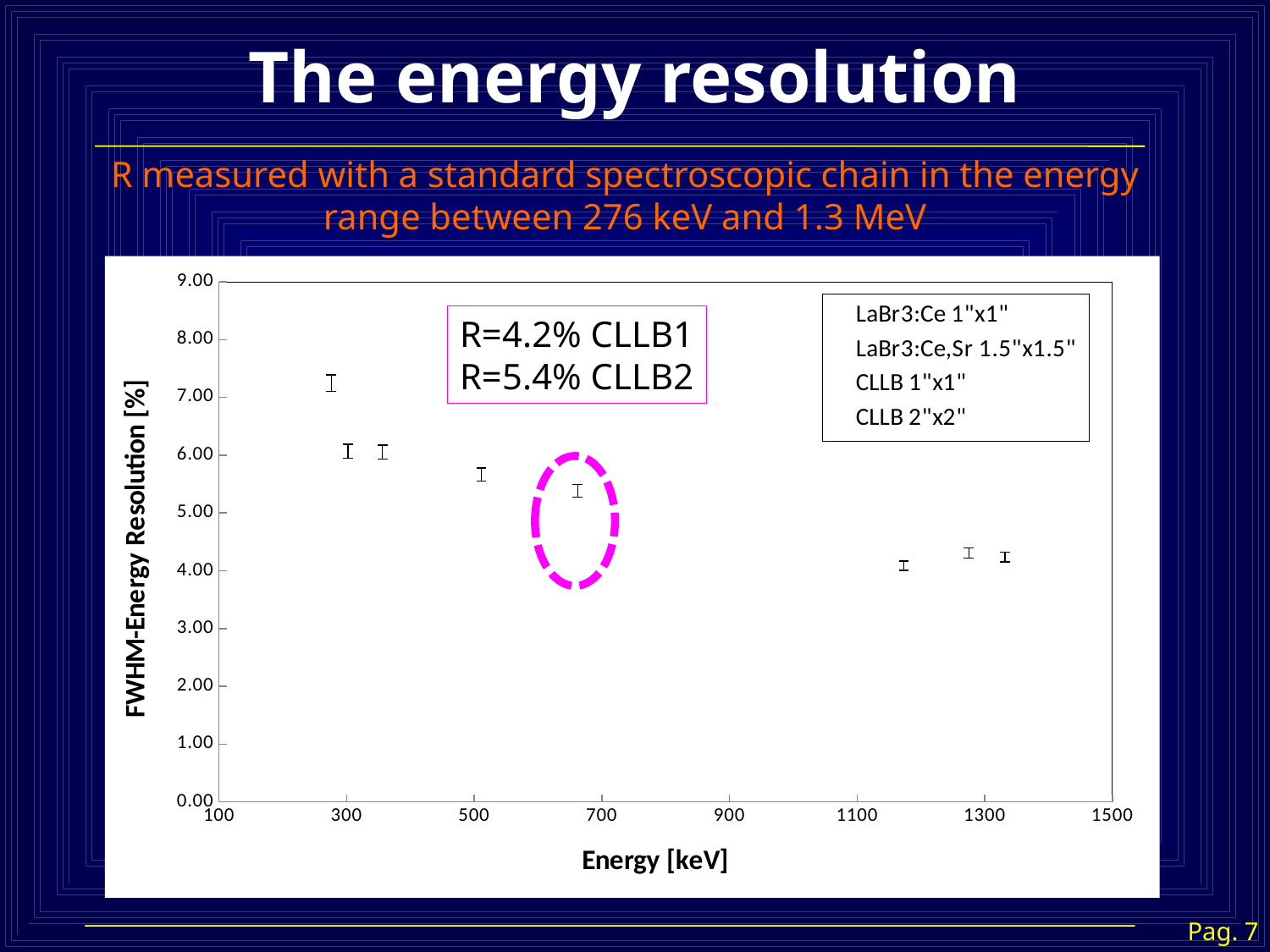
How many data points are plotted on the chart? 8 Do the energy resolution values rise or fall as energy increases along the x axis? fall Is the energy resolution value for the point near 511 keV greater or less than 6.00? less What is the label of the y axis? FWHM-Energy Resolution [%] What is the maximum value shown on the y axis? 9.00 What is the label of the x axis? Energy [keV] Which has the larger energy resolution value: the point near 276 keV or the point near 1332 keV? the point near 276 keV What kind of chart is shown on the slide? scatter chart Is the energy resolution value for the point near 276 keV greater or less than 7.00? greater How many entries does the legend list? 4 Is the energy resolution value for the circled point near 662 keV greater or less than 5.00? greater